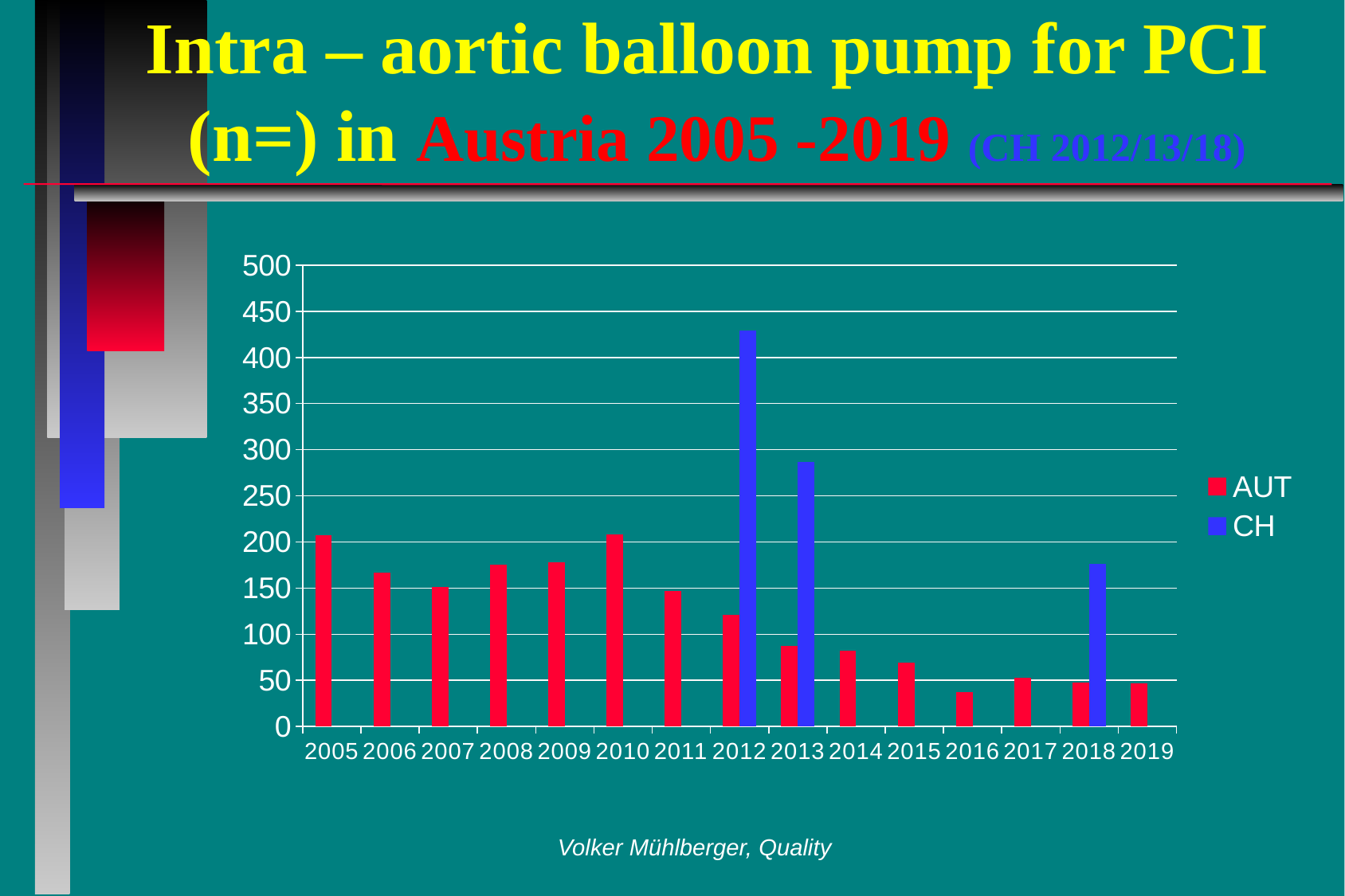
Is the AUT value for 2007 greater or less than 100? greater How many years are shown on the x axis? 15 Is the AUT value for 2016 greater or less than 50? less Which is larger in 2012, the AUT value or the CH value? CH Is the CH value for 2012 greater or less than 400? greater How many series does the legend list? 2 What kind of chart is shown on the slide? bar chart Do the AUT values generally rise or fall from 2005 to 2019? fall What colour are the CH bars? blue In which year is the CH value highest? 2012 In which year is the AUT value lowest? 2016